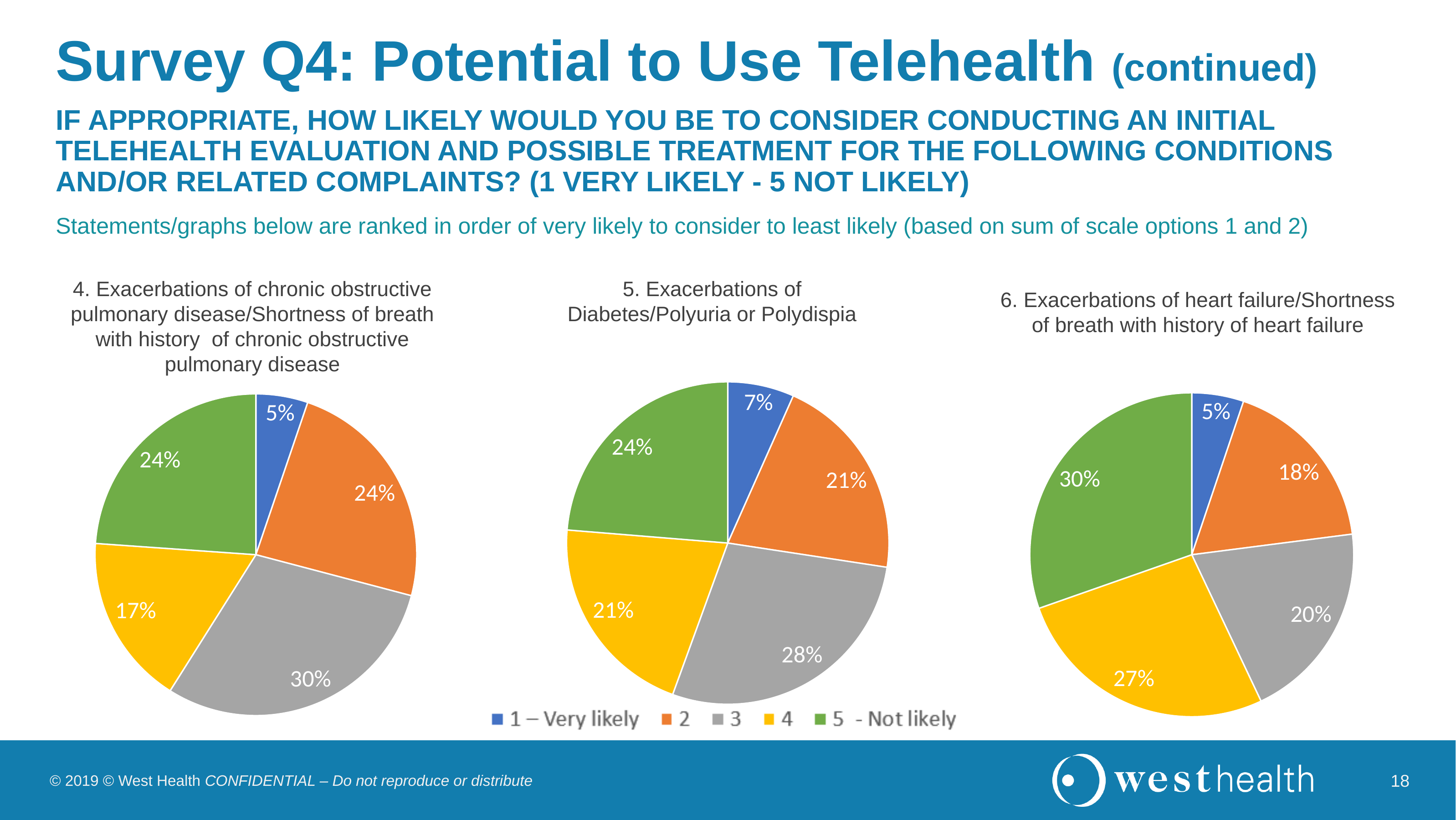
How many entries does the shared legend list? 5 How many pie charts are shown on the slide? 3 In the pie chart for '5. Exacerbations of Diabetes/Polyuria or Polydispia', which scale option has the largest slice? 3 What type of chart is used for '6. Exacerbations of heart failure/Shortness of breath with history of heart failure'? Pie chart In the pie chart for '6. Exacerbations of heart failure', which scale option has the largest slice? 5 - Not likely In the pie chart for '5. Exacerbations of Diabetes/Polyuria or Polydispia', what share is labelled for '1 – Very likely'? 7% In the pie chart for '4. Exacerbations of chronic obstructive pulmonary disease', which is larger: the share for scale option 2 or scale option 4? 2 In the pie chart for '6. Exacerbations of heart failure', what is the difference between the shares for scale option 4 and scale option 2? 9% In the pie chart for '4. Exacerbations of chronic obstructive pulmonary disease', which scale option has the smallest slice? 1 – Very likely In the pie chart for '6. Exacerbations of heart failure/Shortness of breath with history of heart failure', what share is labelled for '5 - Not likely'? 30% In the pie chart for '4. Exacerbations of chronic obstructive pulmonary disease', what share is labelled for scale option 3? 30% In the pie chart for '5. Exacerbations of Diabetes/Polyuria or Polydispia', what is the difference between the shares for scale option 3 and '5 - Not likely'? 4%